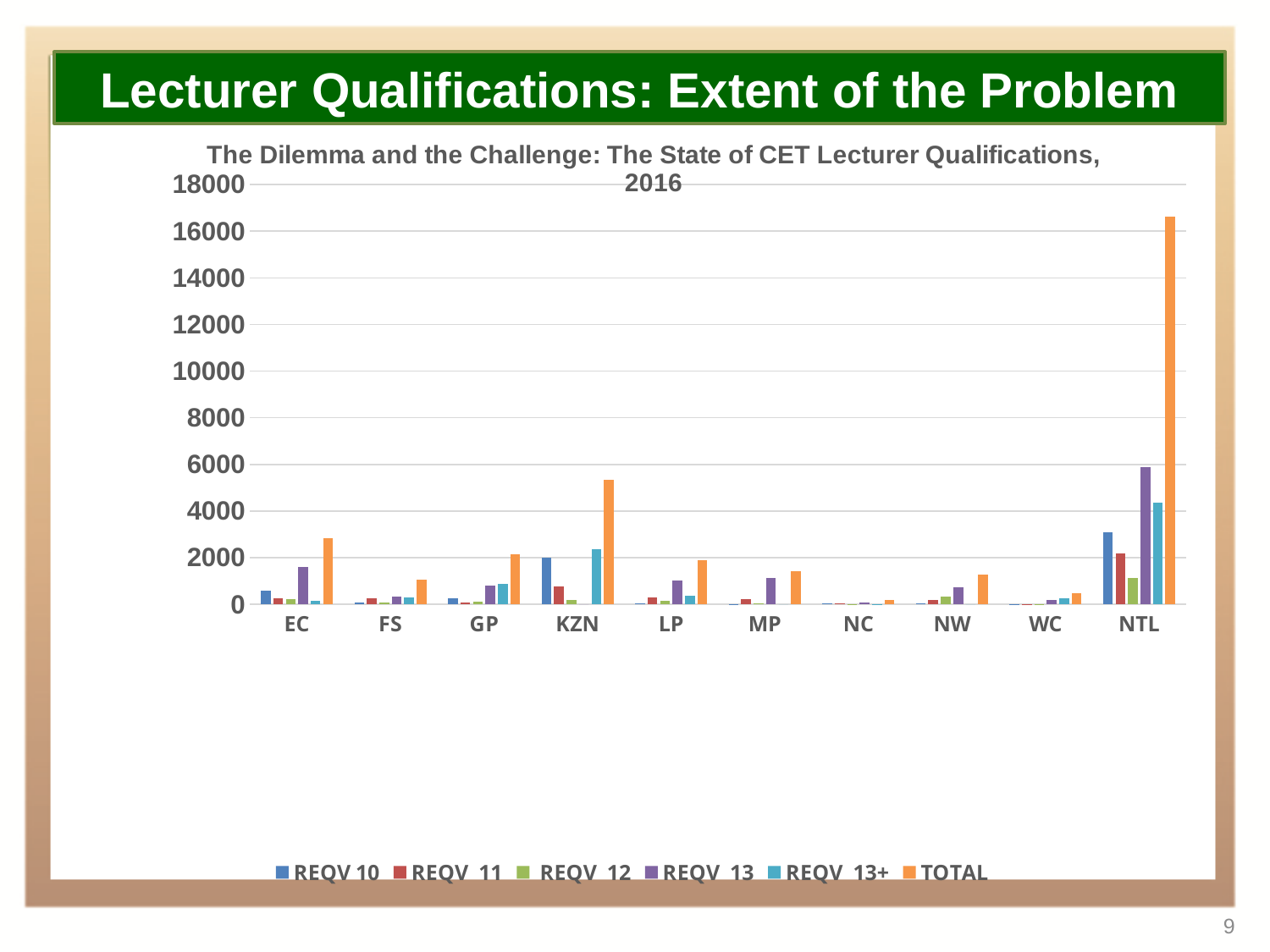
Is the TOTAL value for NTL greater or less than 14000? greater For NTL, which is larger: the REQV 13 bar or the REQV 13+ bar? REQV 13 What kind of chart is shown on the slide? bar chart How many categories are shown on the x axis of the chart? 10 How many series does the chart's legend list? 6 Is the TOTAL value for KZN greater or less than 4000? greater Which has the larger TOTAL bar: EC or GP? EC Is the REQV 10 value for KZN greater or less than 1000? greater What is the title of the chart? The Dilemma and the Challenge: The State of CET Lecturer Qualifications, 2016 Which category has the highest TOTAL bar? NTL Which category has the lowest TOTAL bar? NC